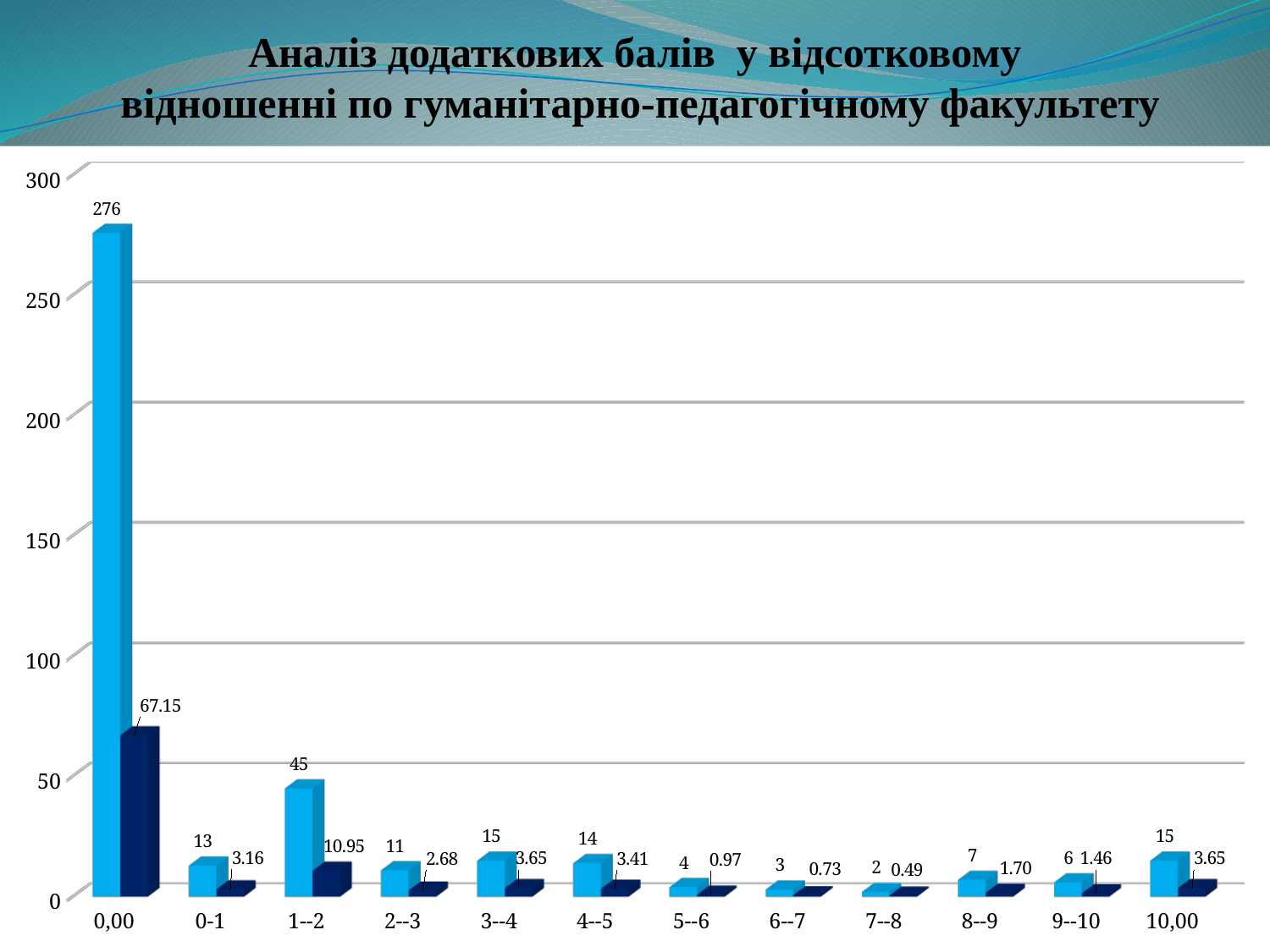
Which is larger, the light blue bar for 3--4 or the light blue bar for 4--5? 3--4 What type of chart is shown on the slide? bar chart Which category has the lowest light blue bar? 7--8 What is the value of the light blue bar for the category 1--2? 45 What is the value of the light blue bar for the category 0,00? 276 What is the value of the dark blue bar for the category 8--9? 1.70 How many categories are shown on the x axis? 12 What is the value of the dark blue bar for the category 10,00? 3.65 Which category has the highest light blue bar? 0,00 What is the value of the dark blue bar for the category 0,00? 67.15 Is the light blue bar for 0,00 greater or less than 250? greater What is the difference between the light blue bars for 0,00 and 1--2? 231